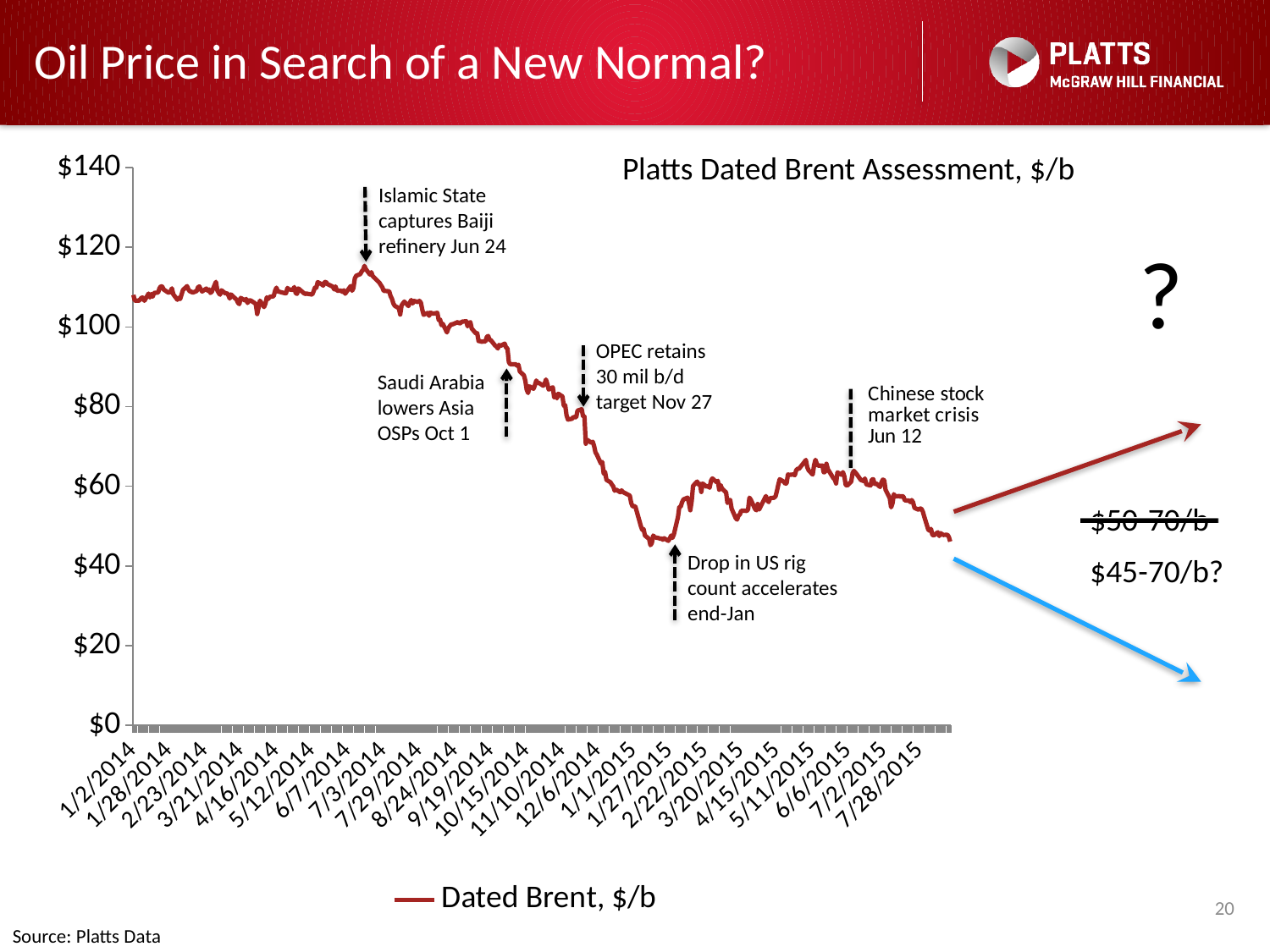
What series name appears in the chart legend? Dated Brent, $/b Which is larger, the Dated Brent value at 1/2/2014 or at 7/28/2015? 1/2/2014 Near which annotated event does the Dated Brent line reach its lowest value before the final decline? Drop in US rig count accelerates end-Jan What is the title of the chart? Platts Dated Brent Assessment, $/b Is the Dated Brent value at 12/6/2014 greater or less than $80? less How many series does the chart legend list? 1 Near which annotated event does the Dated Brent line reach its highest value? Islamic State captures Baiji refinery Jun 24 Is the Dated Brent value at 1/2/2014 greater or less than $100? greater Is the Dated Brent value at 7/28/2015 greater or less than $60? less Overall, does the Dated Brent price rise or fall from the start of the x axis to the end? fall What kind of chart is shown on the slide? line chart